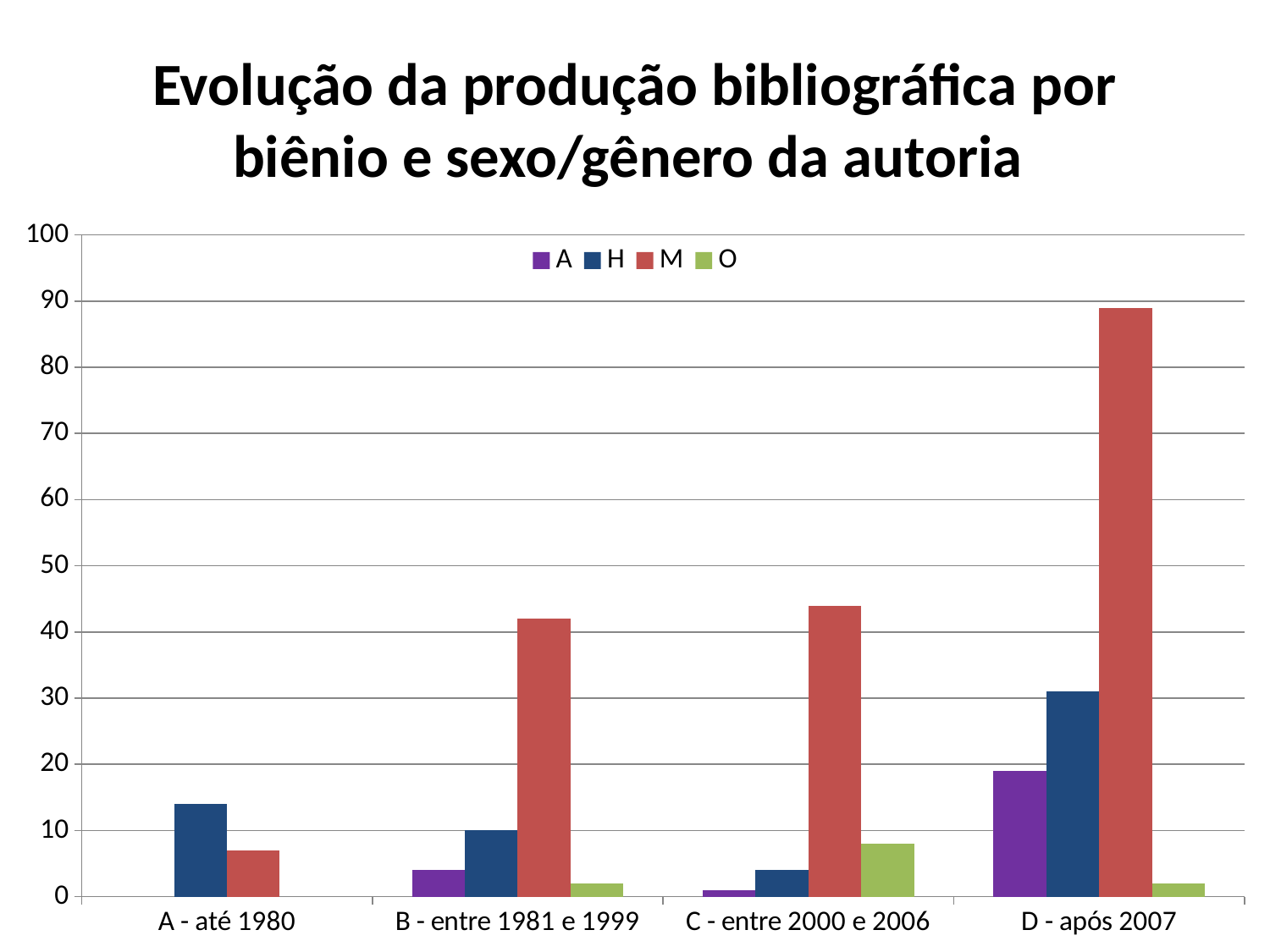
Does the value for series M rise or fall from 'A - até 1980' to 'D - após 2007'? rise Is the value for series M in 'D - após 2007' greater or less than 80? greater In which category is the value for series M lowest? A - até 1980 Is the value for series M in 'C - entre 2000 e 2006' greater or less than 40? greater In 'A - até 1980', which series has the larger value, H or M? H In which category is the value for series M highest? D - após 2007 How many series does the legend list? 4 Is the value for series H in 'A - até 1980' greater or less than 10? greater What are the entries listed in the legend? A, H, M, O What kind of chart is shown on the slide? bar chart How many categories are shown on the x axis? 4